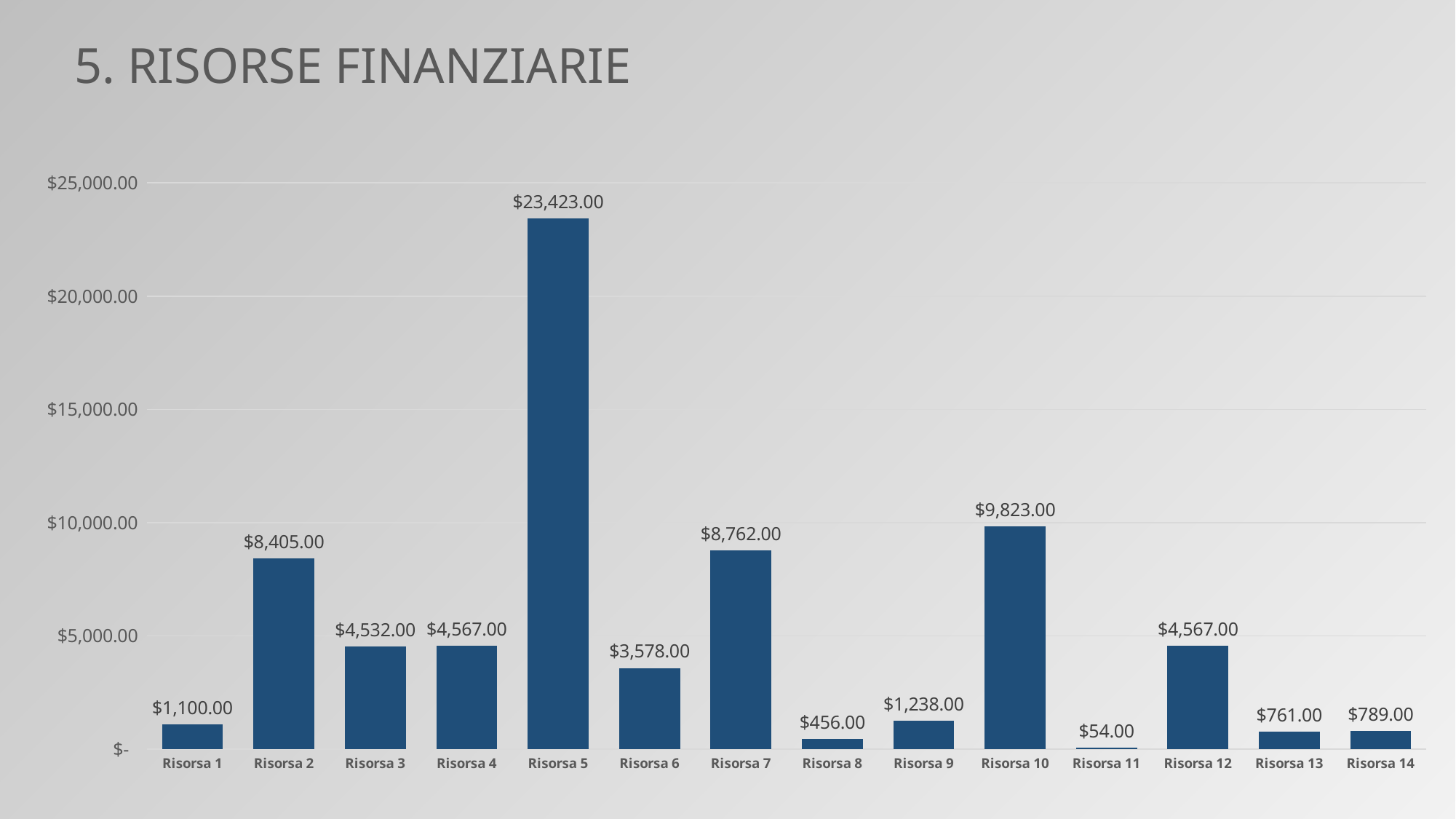
What kind of chart is shown on the slide? bar chart What is the value for Risorsa 11? $54.00 What is the value for Risorsa 10? $9,823.00 Which category has the lowest value? Risorsa 11 Is the value for Risorsa 10 greater or less than $5,000.00? greater What is the value for Risorsa 5? $23,423.00 Which category has the highest value? Risorsa 5 What is the difference between the values for Risorsa 2 and Risorsa 7? $357.00 What is the title of the slide? 5. RISORSE FINANZIARIE How many categories are shown on the chart? 14 Which is larger, the value for Risorsa 13 or the value for Risorsa 14? Risorsa 14 What is the difference between the values for Risorsa 5 and Risorsa 10? $13,600.00